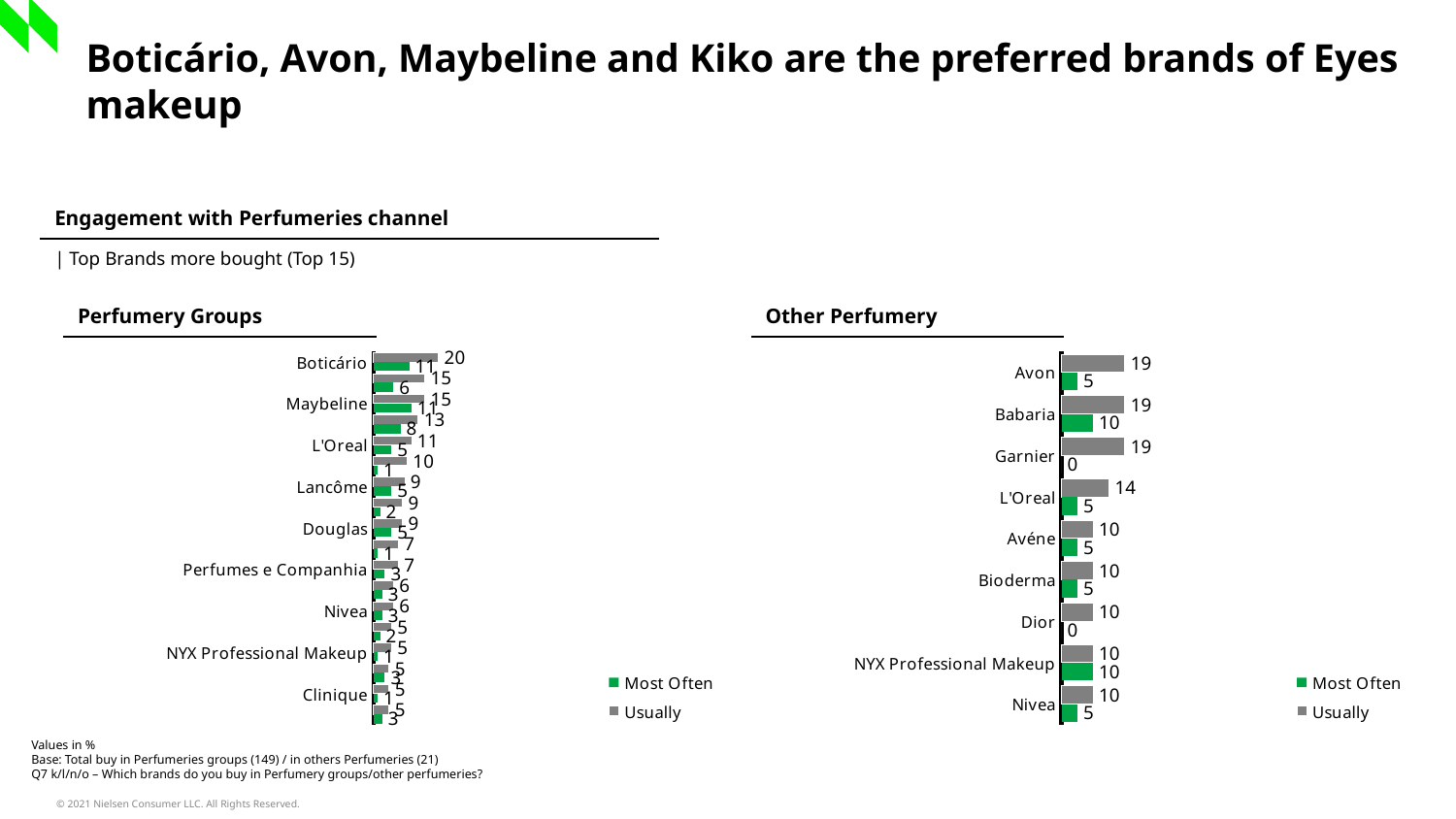
In the Other Perfumery chart, what is the Usually value for L'Oreal? 14 How many brands are shown in the Other Perfumery chart? 9 In the Perfumery Groups chart, which brand has the highest Usually value? Boticário How many series does the legend of the Other Perfumery chart list? 2 In the Other Perfumery chart, what is the Most Often value for NYX Professional Makeup? 10 In the Other Perfumery chart, what is the Usually value for Babaria? 19 What kind of chart is the Other Perfumery chart? Bar chart In the Other Perfumery chart, what is the Most Often value for Garnier? 0 In the Other Perfumery chart, which has the larger Most Often value, Babaria or Avon? Babaria In the Perfumery Groups chart, what is the Usually value for Boticário? 20 In the Other Perfumery chart, what is the difference between the Usually and Most Often values for Babaria? 9 In the Perfumery Groups chart, what is the Most Often value for Boticário? 11